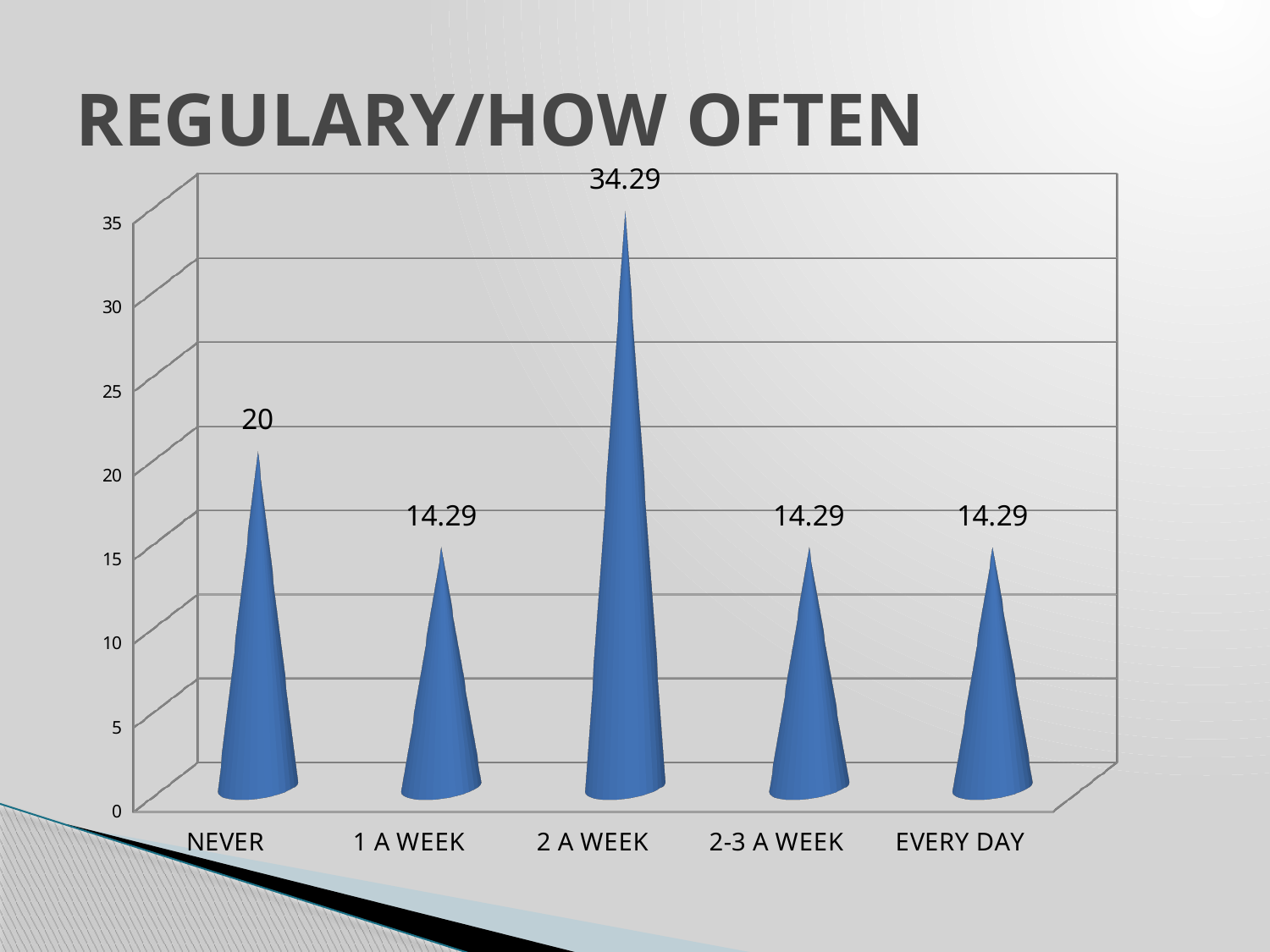
What is the value for EVERY DAY? 14.29 What is the value for 2 A WEEK? 34.29 What is the value for 1 A WEEK? 14.29 What is the difference between the values for NEVER and 1 A WEEK? 5.71 Which category has the highest value? 2 A WEEK How many categories are shown on the x axis? 5 What kind of chart is shown on the slide? bar chart Is the value for 2 A WEEK greater or less than 30? greater What is the value for NEVER? 20 What is the difference between the values for 2 A WEEK and NEVER? 14.29 Which is larger, the value for NEVER or the value for 2-3 A WEEK? NEVER What is the title of the slide? REGULARY/HOW OFTEN